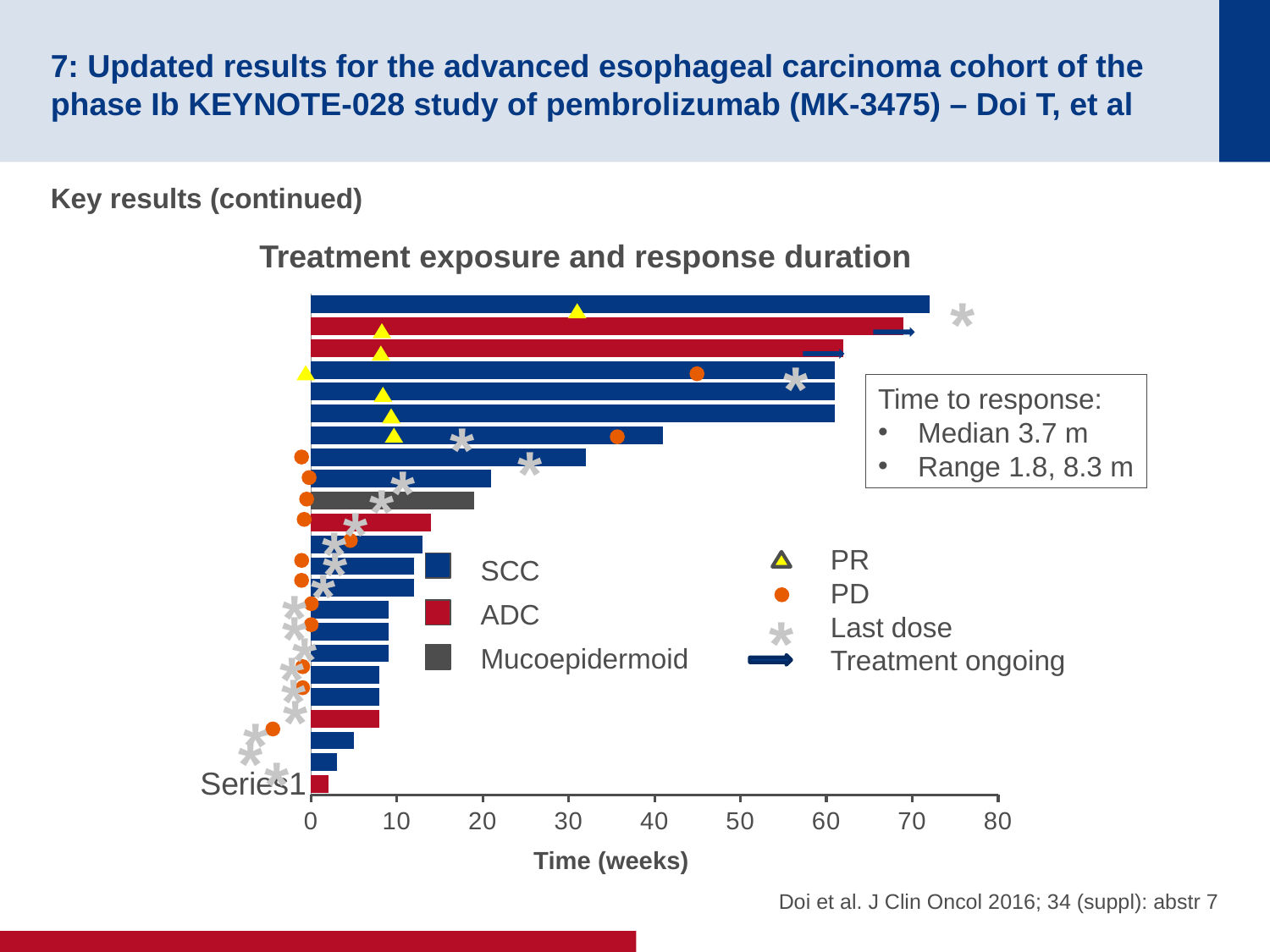
Is the longest red (ADC) bar greater or less than 50 weeks? greater Is the grey (Mucoepidermoid) bar greater or less than 30 weeks? less What is the label of the x axis of the chart? Time (weeks) What is the median time to response stated on the chart? 3.7 m Is the shortest bar on the chart greater or less than 10 weeks? less What kind of chart is shown on the slide? bar chart What is the highest value shown on the x axis of the chart? 80 What is the range of time to response stated on the chart? 1.8, 8.3 m What is the title of the chart? Treatment exposure and response duration